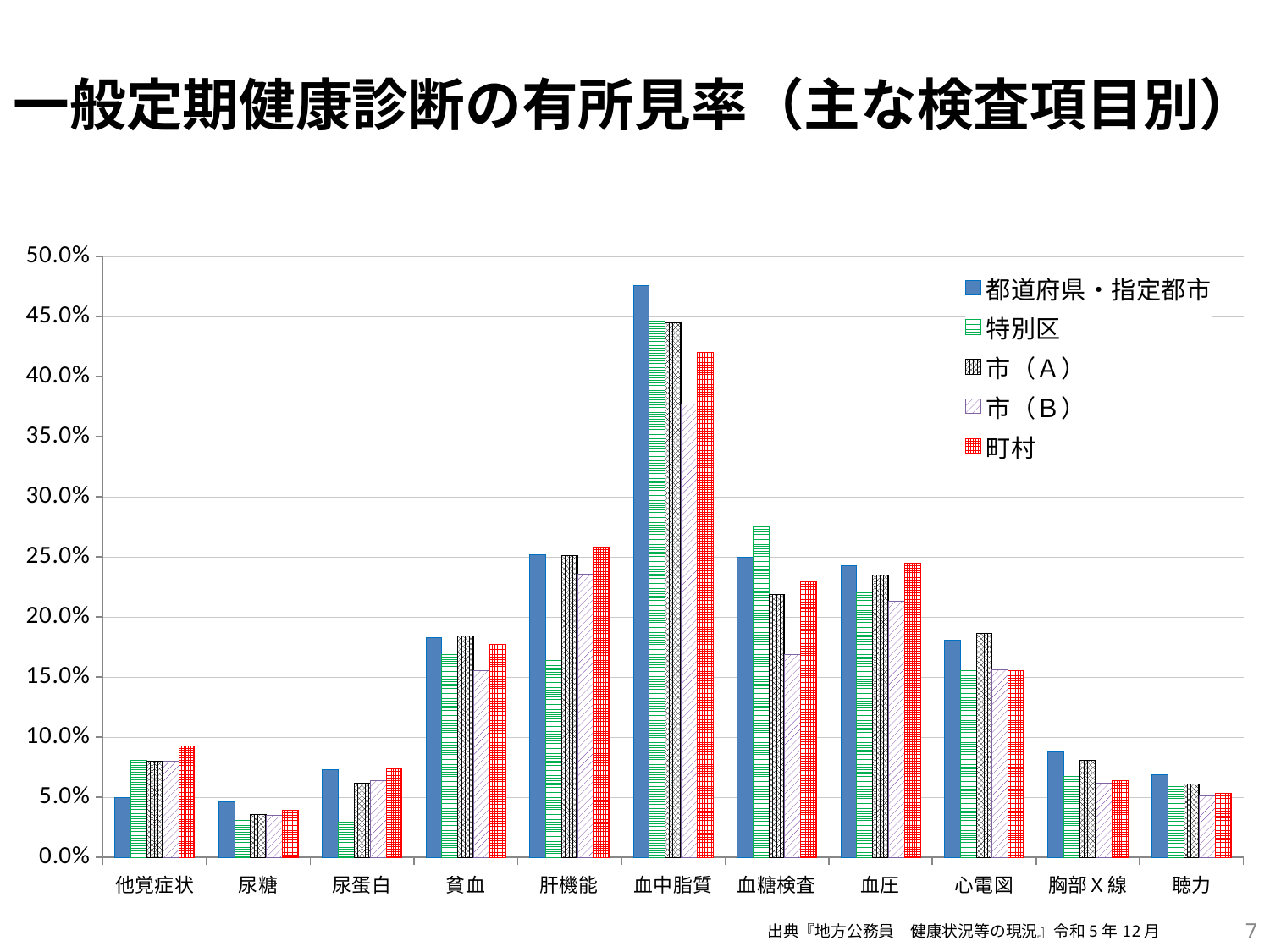
In 血糖検査, which is larger: the value for 都道府県・指定都市 or for 特別区? 特別区 In 血中脂質, which is larger: the value for 市（B） or for 町村? 町村 Is the value for 市（A） in 心電図 greater or less than 15.0%? greater Is the value for 都道府県・指定都市 in 胸部Ｘ線 greater or less than 10.0%? less What kind of chart is shown on the slide? bar chart Which series has the highest value in the 他覚症状 category? 町村 Which category has the lowest value for 町村? 尿糖 How many series does the legend list? 5 Is the value for 特別区 in 血糖検査 greater or less than 25.0%? greater Which category has the highest value for 都道府県・指定都市? 血中脂質 How many categories are shown on the x axis of the chart? 11